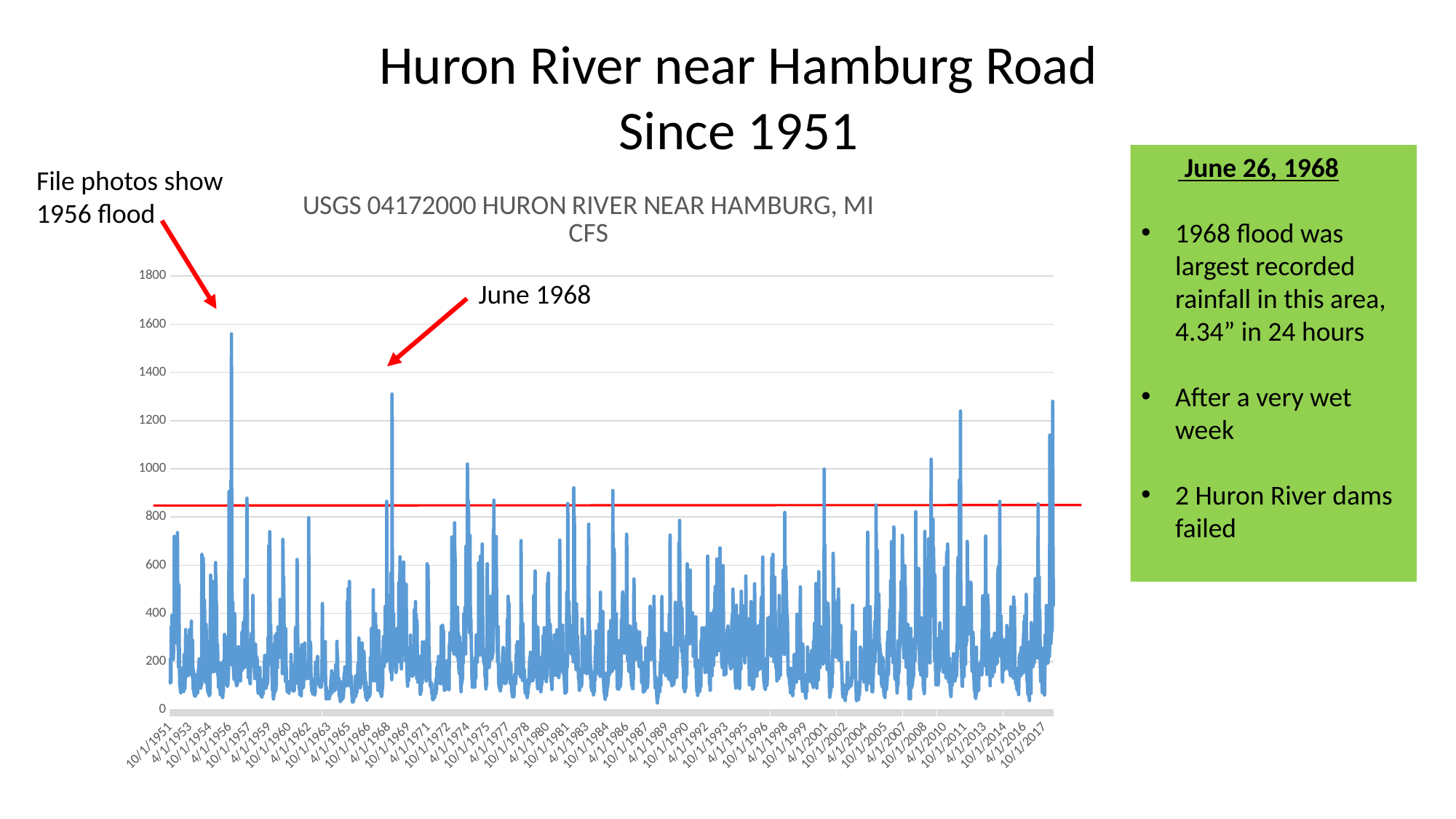
What is the first date label on the horizontal axis? 10/1/1951 Is the peak flow value in 1956 greater or less than 1400? greater What kind of chart is shown on the slide? line chart What is the highest value shown on the vertical axis? 1800 Is the peak flow value in June 1968 greater or less than 1200? greater Is the peak flow value in June 1968 greater or less than 1400? less What is the last date label on the horizontal axis? 10/1/2017 Which flood peak is higher on the chart, the 1956 flood or the June 1968 flood? 1956 flood What is the title of the chart? USGS 04172000 HURON RIVER NEAR HAMBURG, MI CFS In which year does the chart show its highest peak flow? 1956